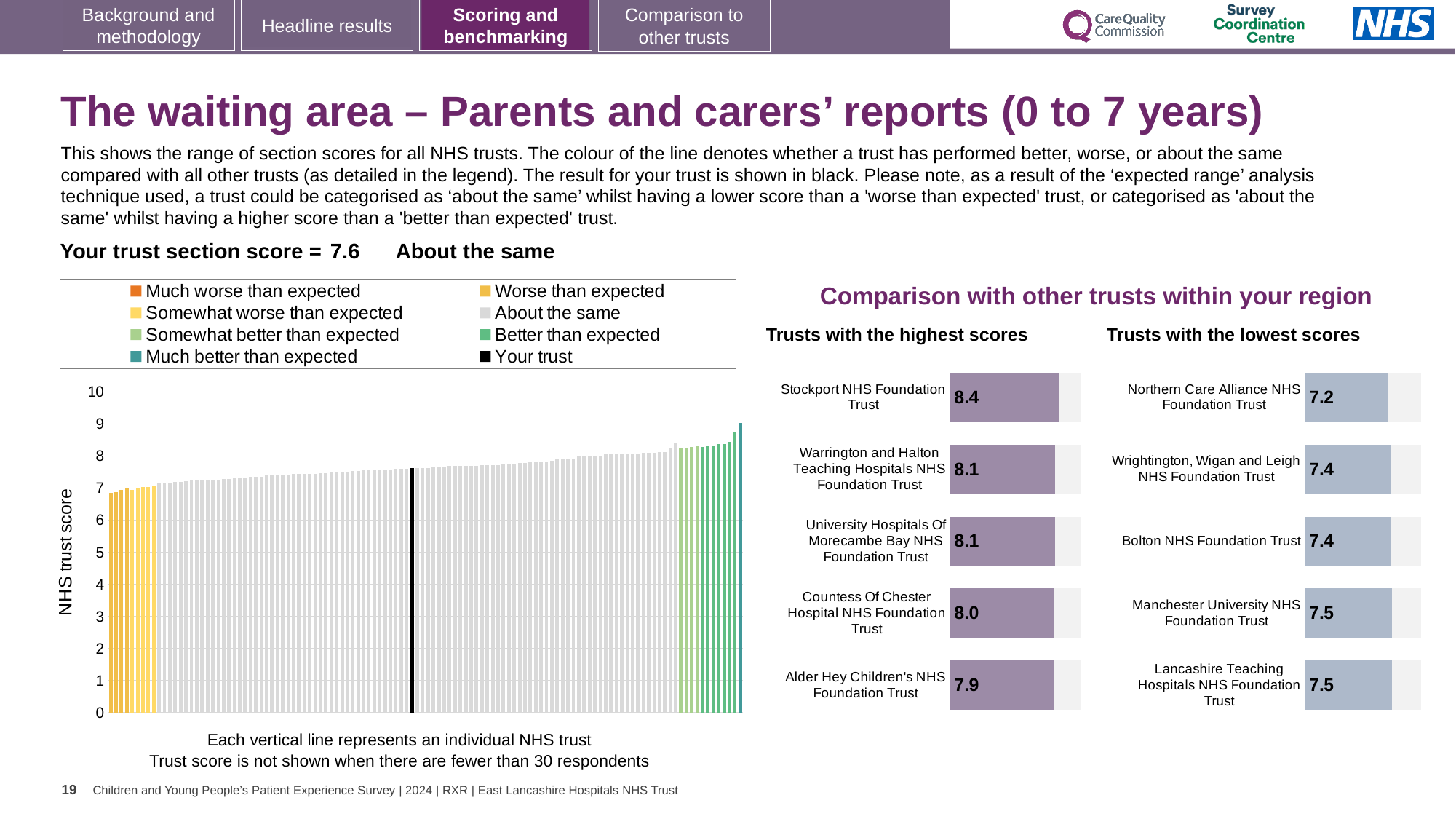
In the 'Trusts with the lowest scores' chart, which trust has the lowest score? Northern Care Alliance NHS Foundation Trust In the main 'NHS trust score' chart on the left, is the value for the black bar (your trust) greater or less than 7? greater In the 'Trusts with the lowest scores' chart, what is the score for Bolton NHS Foundation Trust? 7.4 In the 'Trusts with the highest scores' chart, which trust has the highest score? Stockport NHS Foundation Trust In the 'Trusts with the highest scores' chart, what is the score for Alder Hey Children's NHS Foundation Trust? 7.9 In the 'Trusts with the highest scores' chart, what is the score for Stockport NHS Foundation Trust? 8.4 In the 'Trusts with the lowest scores' chart, what is the difference between the scores of Manchester University NHS Foundation Trust and Northern Care Alliance NHS Foundation Trust? 0.3 In the 'Trusts with the lowest scores' chart, what is the score for Northern Care Alliance NHS Foundation Trust? 7.2 How many entries does the legend of the main 'NHS trust score' chart on the left list? 8 In the main 'NHS trust score' chart on the left, do the bar values rise or fall from left to right? rise In the 'Trusts with the highest scores' chart, what is the difference between the scores of Stockport NHS Foundation Trust and Alder Hey Children's NHS Foundation Trust? 0.5 In the 'Trusts with the highest scores' chart, how many trusts are listed? 5